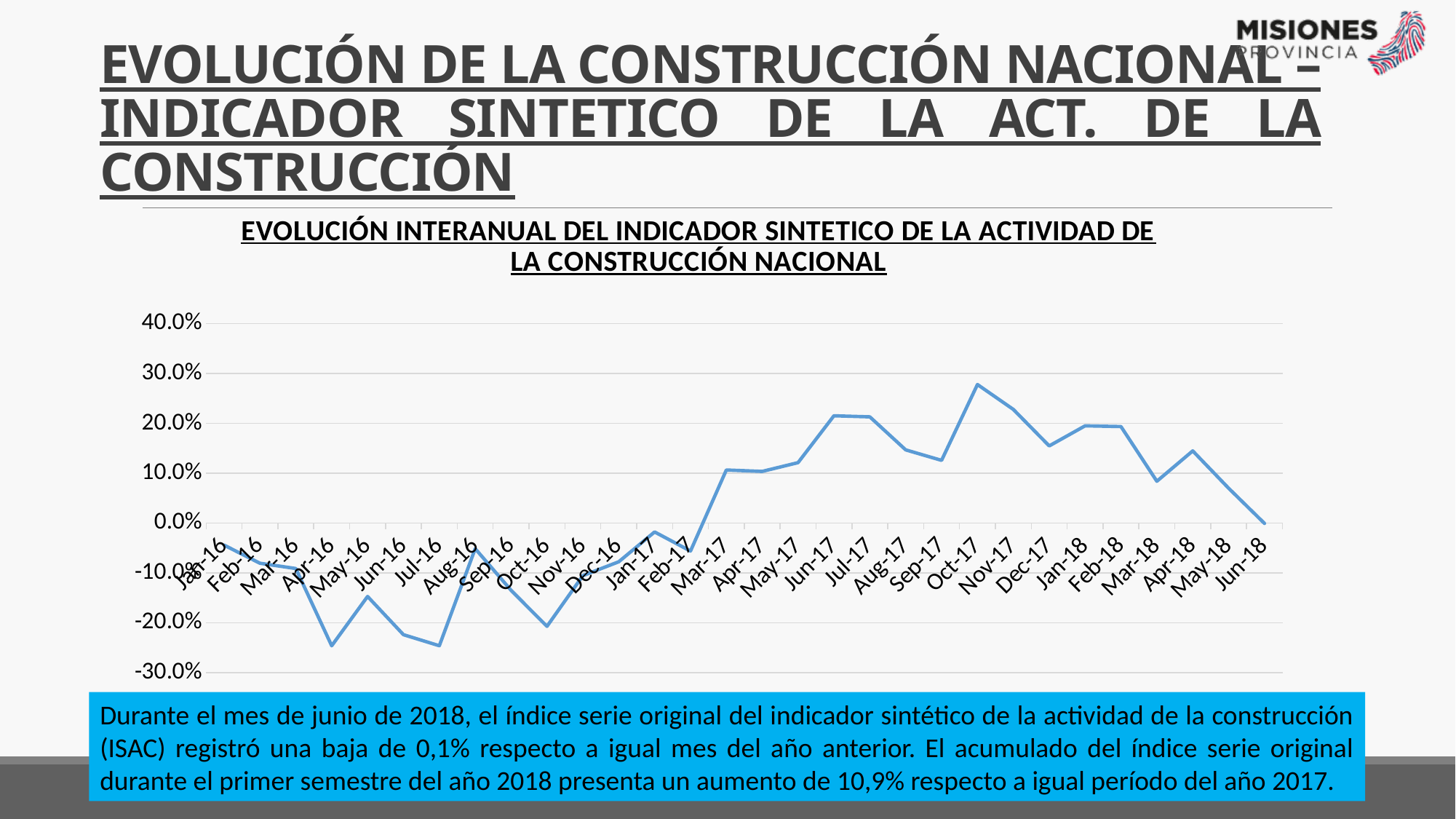
Which month has the highest value on the chart? Oct-17 Which is larger, the value for Jan-16 or the value for Apr-16? Jan-16 Is the value for Oct-17 greater or less than 20.0%? greater Do the values rise or fall from Feb-17 to Jun-17? rise Which is larger, the value for Oct-17 or the value for Dec-17? Oct-17 Is the value for Mar-17 greater or less than 0.0%? greater What is the highest tick value shown on the vertical axis? 40.0% What kind of chart is shown on the slide? line chart Is the value for Jul-17 greater or less than 10.0%? greater How many monthly data points are plotted on the chart? 30 Do the values rise or fall from Feb-18 to Jun-18? fall